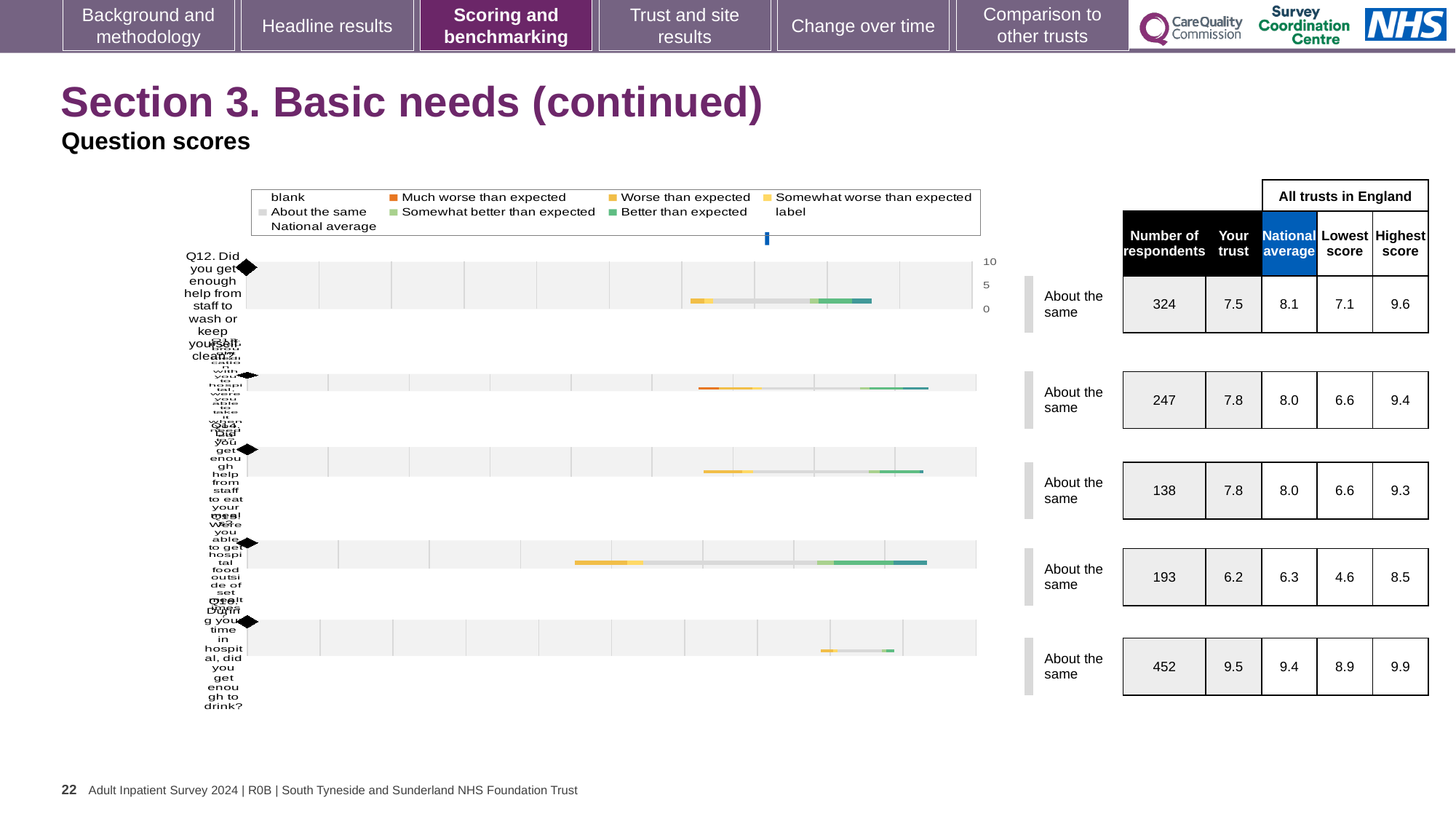
What is the lowest 'Your trust' score shown in the table? 6.2 How many question rows (bars) does the chart show? 5 What is the 'Your trust' score for Q16 (did you get enough to drink)? 9.5 What is the difference between the national average and the 'Your trust' score for Q12? 0.6 For Q16 (did you get enough to drink), which is larger: the 'Your trust' score or the national average? Your trust Which row has the highest 'Your trust' score? Q16 (did you get enough to drink), 9.5 What kind of chart is shown on the slide? bar chart What colour does the legend use for 'Much worse than expected'? orange How many respondents are listed for Q12 (help from staff to wash or keep yourself clean)? 324 What is the national average for Q16 (did you get enough to drink)? 9.4 What benchmark category is given for Q12 (help from staff to wash or keep yourself clean)? About the same What is the 'Your trust' score for Q12 (help from staff to wash or keep yourself clean)? 7.5